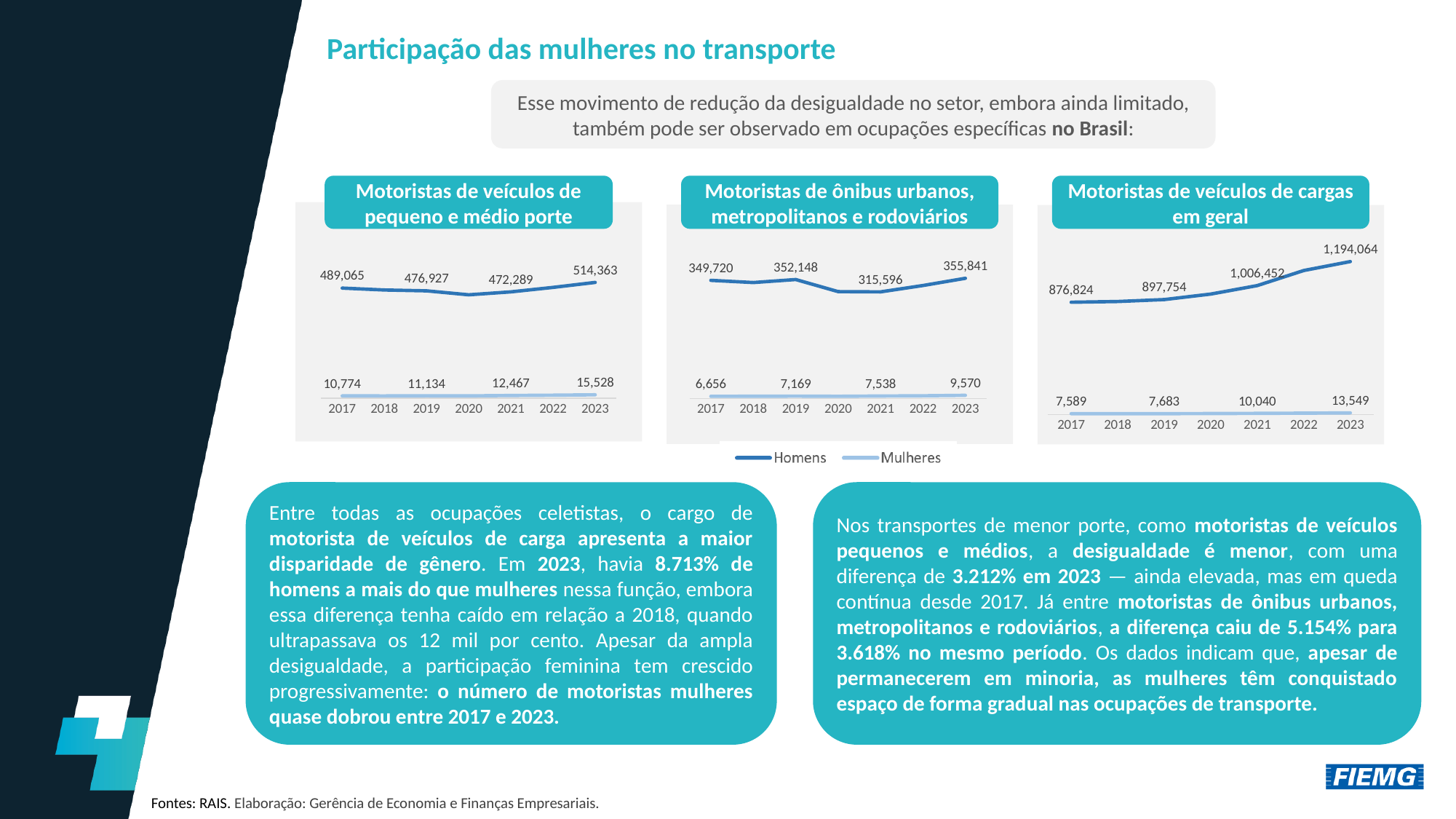
What kind of chart is 'Motoristas de veículos de cargas em geral'? line chart In the chart 'Motoristas de ônibus urbanos, metropolitanos e rodoviários', is the Homens value for 2019 larger or smaller than the Homens value for 2023? smaller In the chart 'Motoristas de veículos de cargas em geral', what is the difference between the Mulheres values for 2023 and 2017? 5,960 In the chart 'Motoristas de veículos de cargas em geral', does the Homens series rise or fall from 2017 to 2023? rise In the chart 'Motoristas de ônibus urbanos, metropolitanos e rodoviários', what is the value for Mulheres in 2023? 9,570 In the chart 'Motoristas de veículos de pequeno e médio porte', what is the value for Mulheres in 2017? 10,774 In the chart 'Motoristas de veículos de pequeno e médio porte', what is the value for Homens in 2023? 514,363 In the chart 'Motoristas de veículos de pequeno e médio porte', which labelled year has the lowest value for Homens? 2021 In the chart 'Motoristas de ônibus urbanos, metropolitanos e rodoviários', what is the value for Homens in 2021? 315,596 In the chart 'Motoristas de veículos de cargas em geral', what is the value for Homens in 2023? 1,194,064 How many series does the legend list for the charts? 2 In the chart 'Motoristas de veículos de cargas em geral', which labelled year has the lowest value for Mulheres? 2017